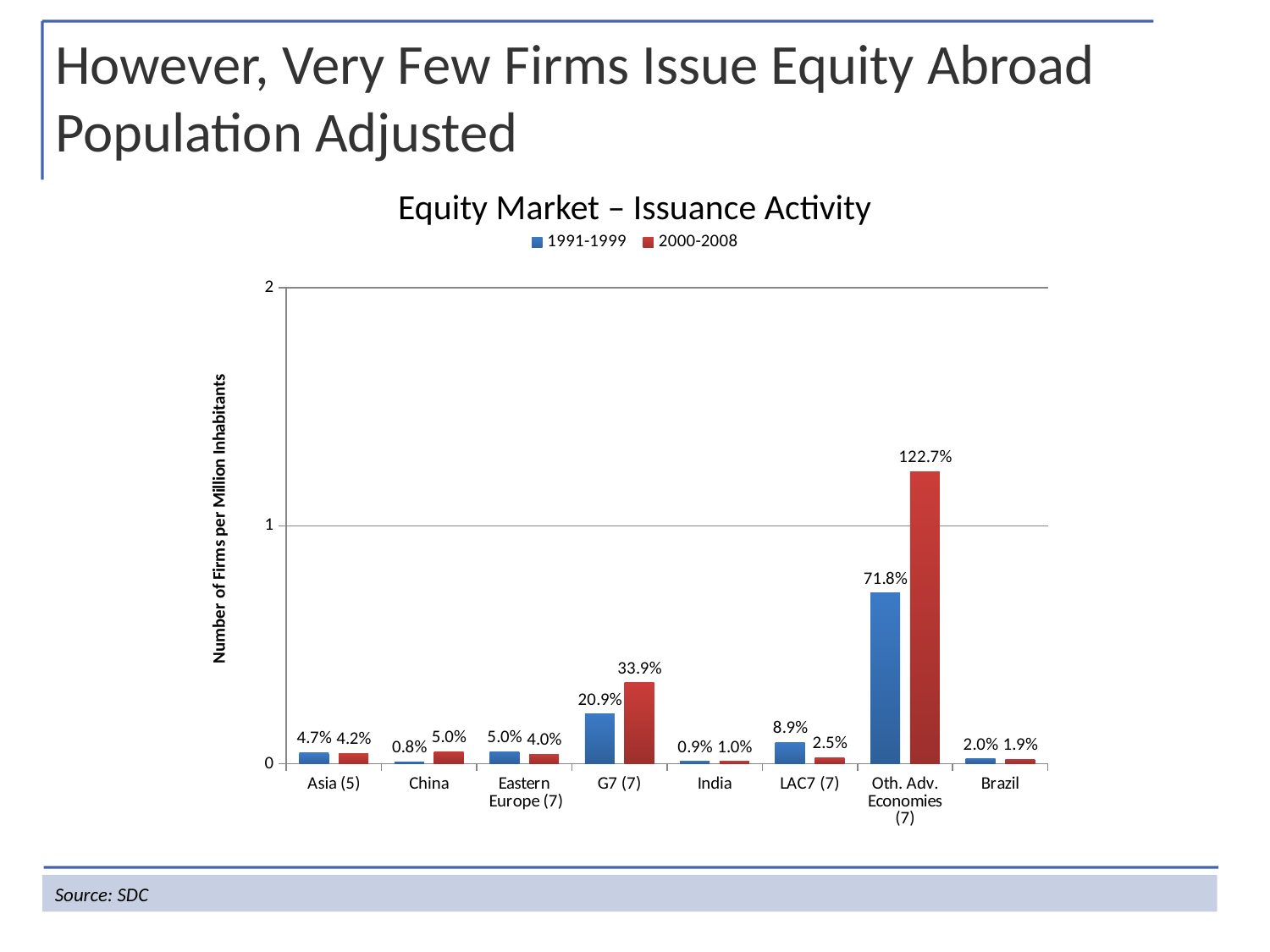
Which category has the lowest value in the 1991-1999 series? China What kind of chart is shown on the slide? bar chart How many categories are shown on the x axis? 8 What is the value for China in the 2000-2008 series? 5.0% Is the 2000-2008 value for Oth. Adv. Economies (7) greater or less than 1 on the y axis? greater What is the title of the chart? Equity Market – Issuance Activity What is the value for Oth. Adv. Economies (7) in the 2000-2008 series? 122.7% What is the difference between the 2000-2008 and 1991-1999 values for G7 (7)? 13.0% What is the value for G7 (7) in the 1991-1999 series? 20.9% How many series does the legend list? 2 Which category has the highest value in the 1991-1999 series? Oth. Adv. Economies (7) Which is larger for LAC7 (7): the 1991-1999 value or the 2000-2008 value? 1991-1999